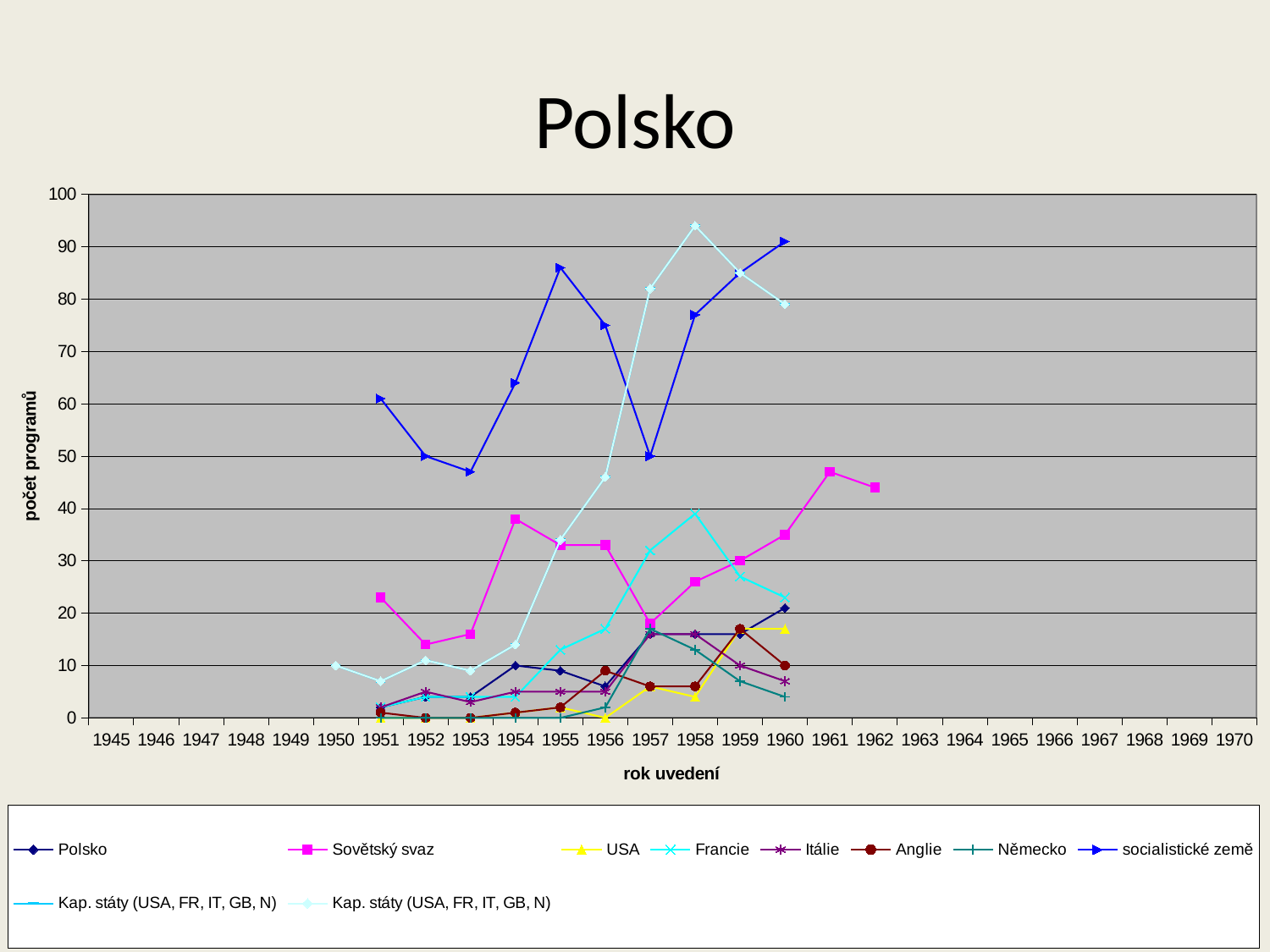
What kind of chart is shown on the slide? line chart Does the value for socialistické země rise or fall from 1957 to 1960? rise How many year labels are shown on the x axis? 26 Is the value for Francie in 1958 greater or less than 30? greater Is the value for Sovětský svaz in 1961 greater or less than 40? greater Is the value for socialistické země in 1955 greater or less than 80? greater What is the title of the chart? Polsko In 1960, which series has the larger value: socialistické země or Sovětský svaz? socialistické země What is the label of the vertical axis? počet programů How many series does the legend list? 10 What is the value for socialistické země in 1952? 50